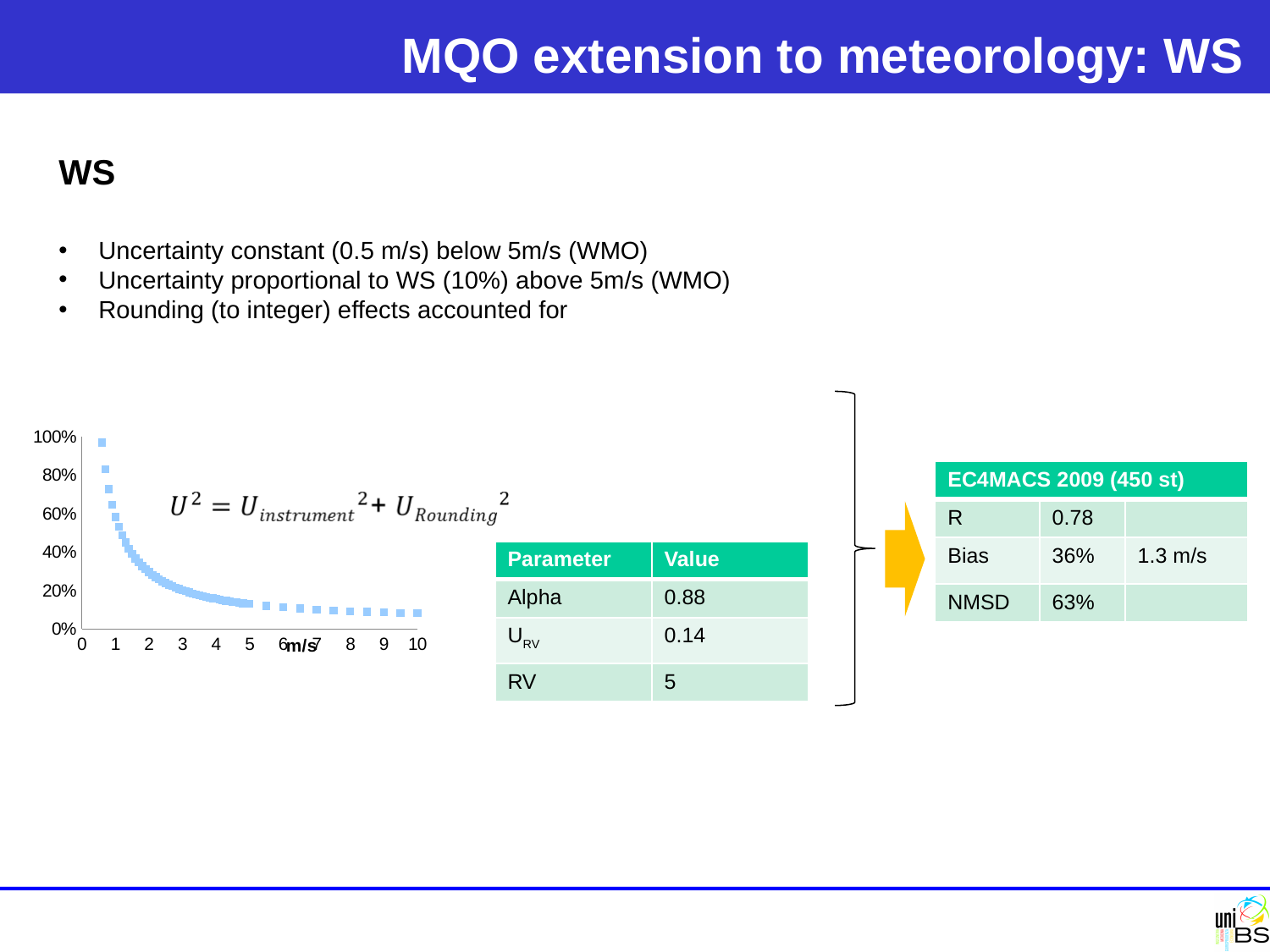
What is the maximum value shown on the y axis of the chart? 100% At which end of the x axis, 0 or 10 m/s, are the plotted values higher? 0 Do the plotted values rise or fall as wind speed increases along the x axis? fall Is the plotted value at 5 m/s greater or less than 20%? less Is the plotted value at 10 m/s greater or less than 20%? less Is the highest plotted value greater or less than 80%? greater What unit is labelled on the x axis of the chart? m/s What kind of chart is shown on the slide? scatter chart